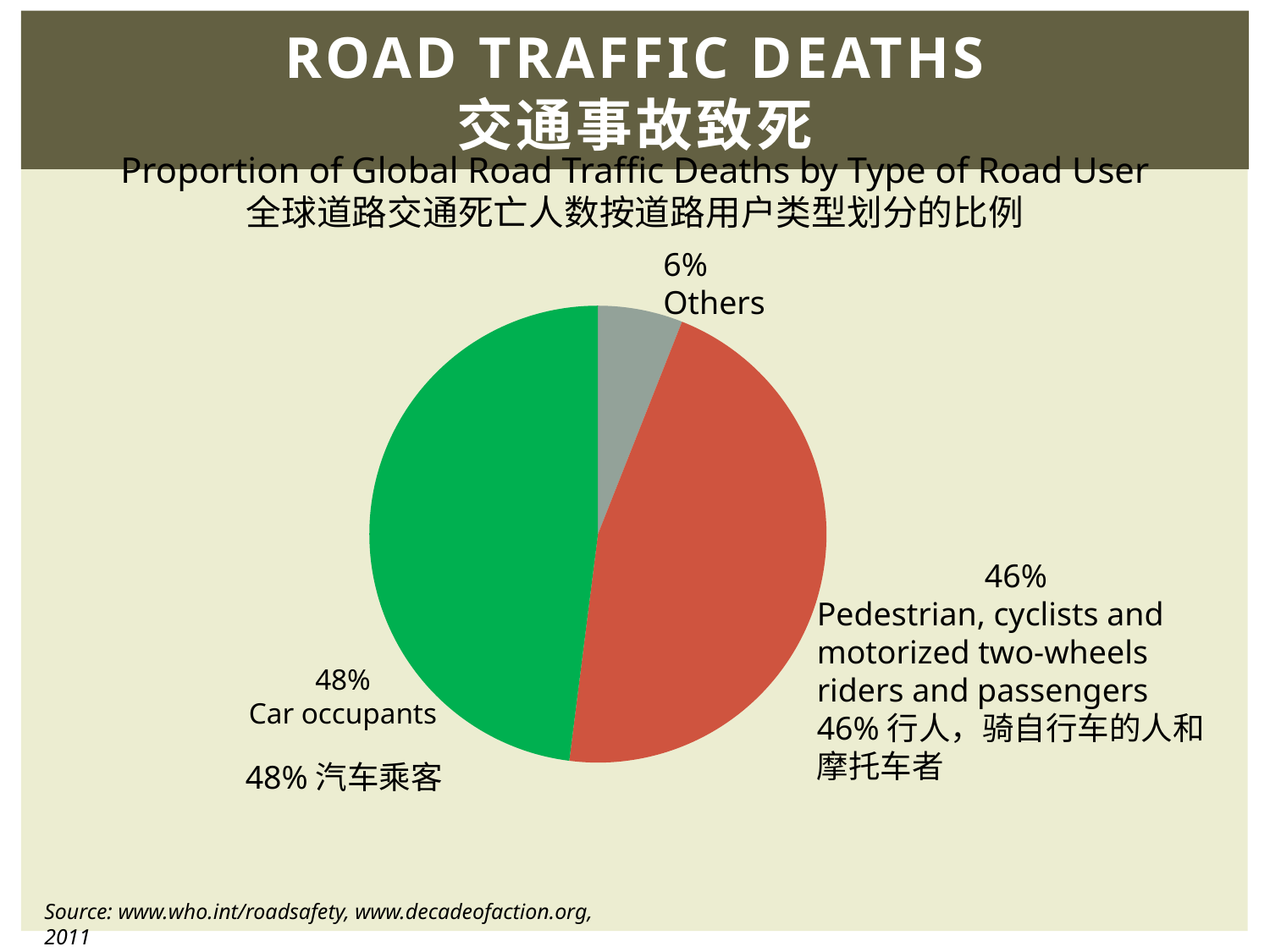
What share of global road traffic deaths is attributed to Others? 6% What is the difference in percentage points between the Car occupants share and the Others share? 42 How many slices does the pie chart have? 3 Which category has the smallest share of global road traffic deaths? Others What type of chart is shown on the slide? Pie chart What share of global road traffic deaths is attributed to pedestrians, cyclists and motorized two-wheels riders and passengers? 46% What is the English title of the chart? Proportion of Global Road Traffic Deaths by Type of Road User What share of global road traffic deaths is attributed to car occupants? 48% Which is larger: the share for Car occupants or the share for Others? Car occupants What is the difference in percentage points between the Car occupants share and the Pedestrian, cyclists and motorized two-wheels riders and passengers share? 2 What colour is the Car occupants slice? Green Which category has the largest share of global road traffic deaths? Car occupants